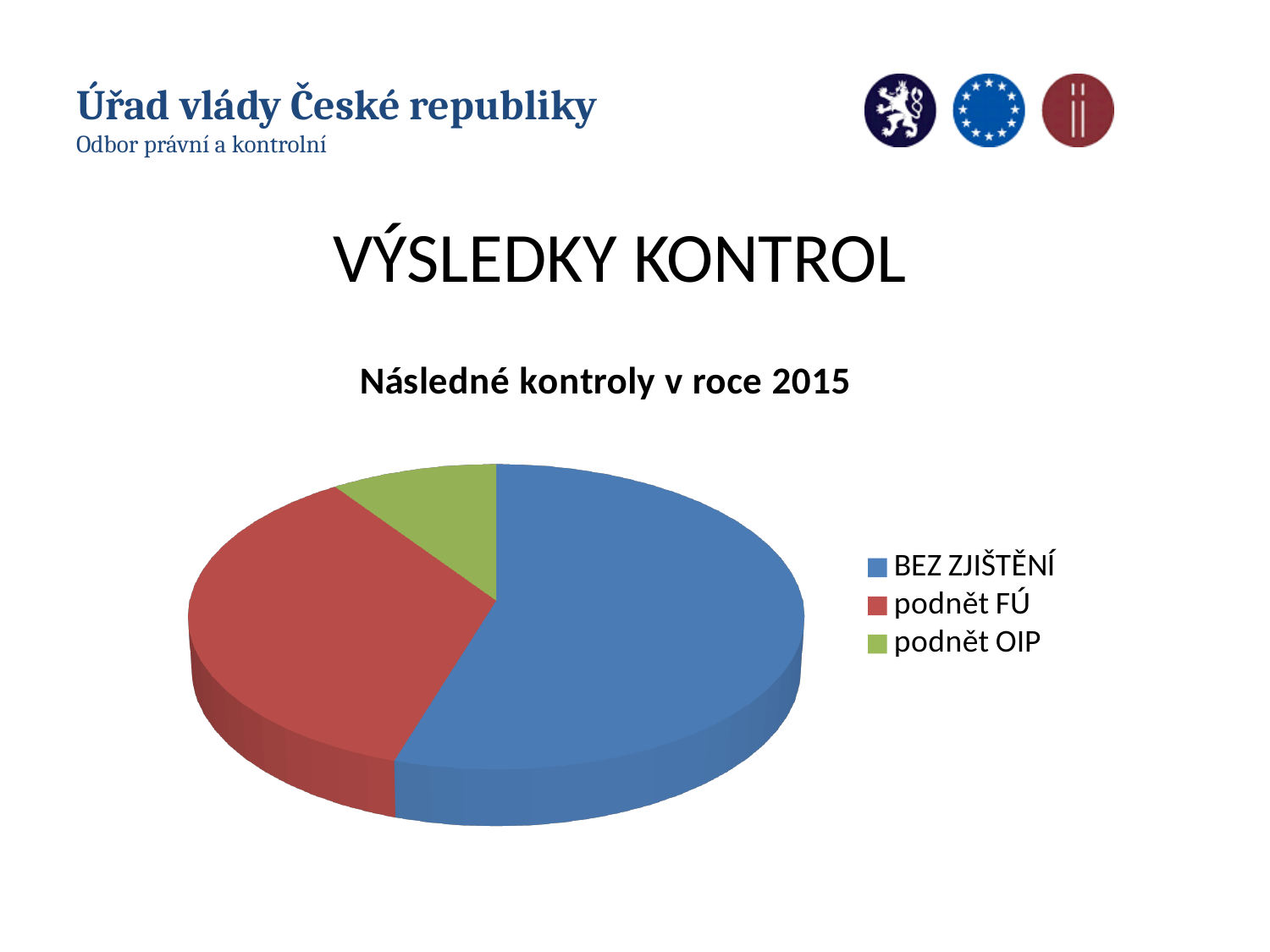
Which category has the smallest slice of the pie? podnět OIP How many entries does the legend list? 3 What colour is the slice for podnět OIP? green Which category has the largest slice of the pie? BEZ ZJIŠTĚNÍ How many slices does the pie chart have? 3 Which slice is larger, BEZ ZJIŠTĚNÍ or podnět FÚ? BEZ ZJIŠTĚNÍ What is the title of the chart? Následné kontroly v roce 2015 Which slice is larger, podnět FÚ or podnět OIP? podnět FÚ What kind of chart is shown on the slide? pie chart Is the share of BEZ ZJIŠTĚNÍ greater or less than half of the pie? greater